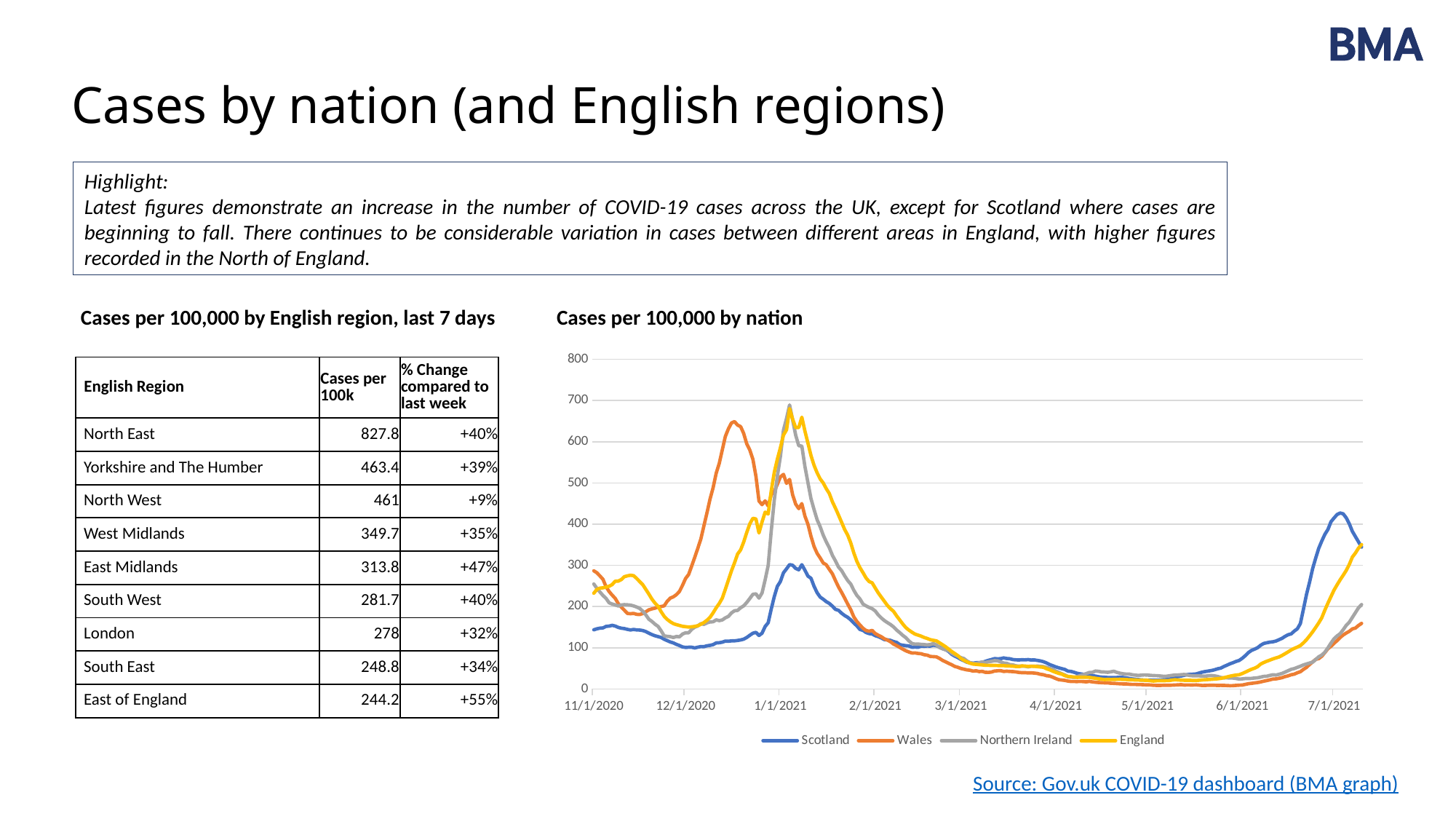
In the 'Cases per 100,000 by nation' chart, is the value for Wales at 11/1/2020 greater or less than 200? greater In the 'Cases per 100,000 by nation' chart, which colour is used for the Scotland line? blue In the 'Cases per 100,000 by nation' chart, is the peak value for Scotland around 7/1/2021 greater or less than 400? greater How many series does the legend of the 'Cases per 100,000 by nation' chart list? 4 In the 'Cases per 100,000 by nation' chart, is the peak value for Wales in December 2020 greater or less than 600? greater In the 'Cases per 100,000 by nation' chart, does the Scotland line rise or fall between 6/1/2021 and 7/1/2021? rise In the 'Cases per 100,000 by nation' chart, at 7/1/2021 is the value for Scotland or Wales larger? Scotland In the 'Cases per 100,000 by nation' chart, which nation has the highest value in mid-December 2020? Wales What kind of chart is shown under the title 'Cases per 100,000 by nation'? line chart Which nations are listed in the legend of the 'Cases per 100,000 by nation' chart? Scotland, Wales, Northern Ireland, England